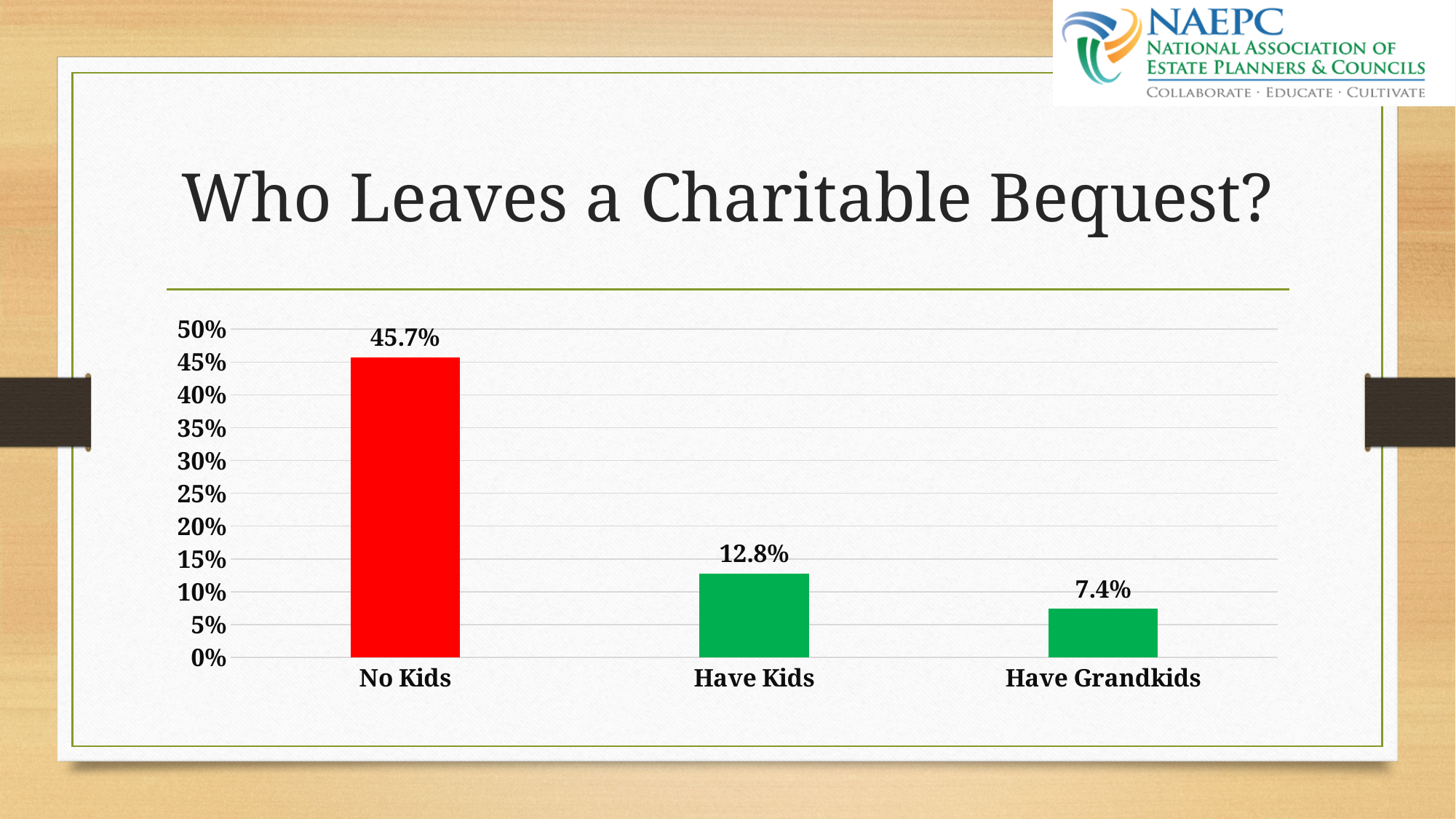
Which category has the lowest value? Have Grandkids Which category has the highest value? No Kids What is the value for Have Grandkids? 7.4% What is the value for Have Kids? 12.8% What is the value for No Kids? 45.7% Is the value for No Kids greater or less than 40%? greater What is the difference between the values for Have Kids and Have Grandkids? 5.4% Which is larger, the value for Have Kids or the value for Have Grandkids? Have Kids What kind of chart is shown on the slide? bar chart How many categories are shown on the chart? 3 What colour is the bar for No Kids? red What is the difference between the values for No Kids and Have Kids? 32.9%